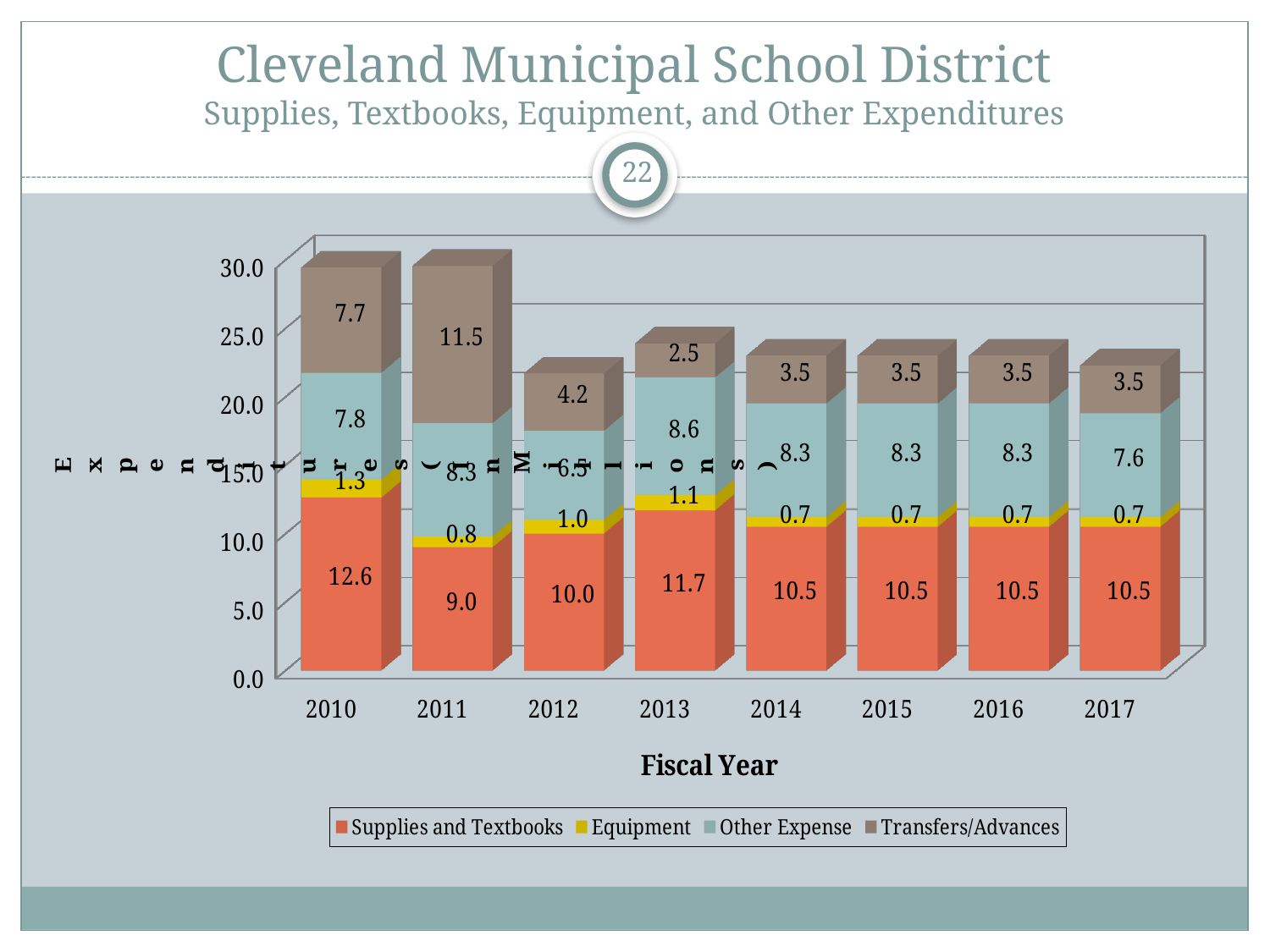
What kind of chart is shown on the slide? Stacked bar chart What is the value for Transfers/Advances in fiscal year 2011? 11.5 What is the total of the stacked bar for fiscal year 2010? 29.4 In which fiscal year is the Transfers/Advances value highest? 2011 Which fiscal year has the larger Transfers/Advances value, 2010 or 2012? 2010 In which fiscal year is the Supplies and Textbooks value lowest? 2011 What is the title of the x axis? Fiscal Year What is the value for Supplies and Textbooks in fiscal year 2010? 12.6 How many series does the legend list? 4 What is the value for Other Expense in fiscal year 2017? 7.6 What is the difference between the Supplies and Textbooks values for 2010 and 2011? 3.6 How many fiscal years are shown on the x axis? 8